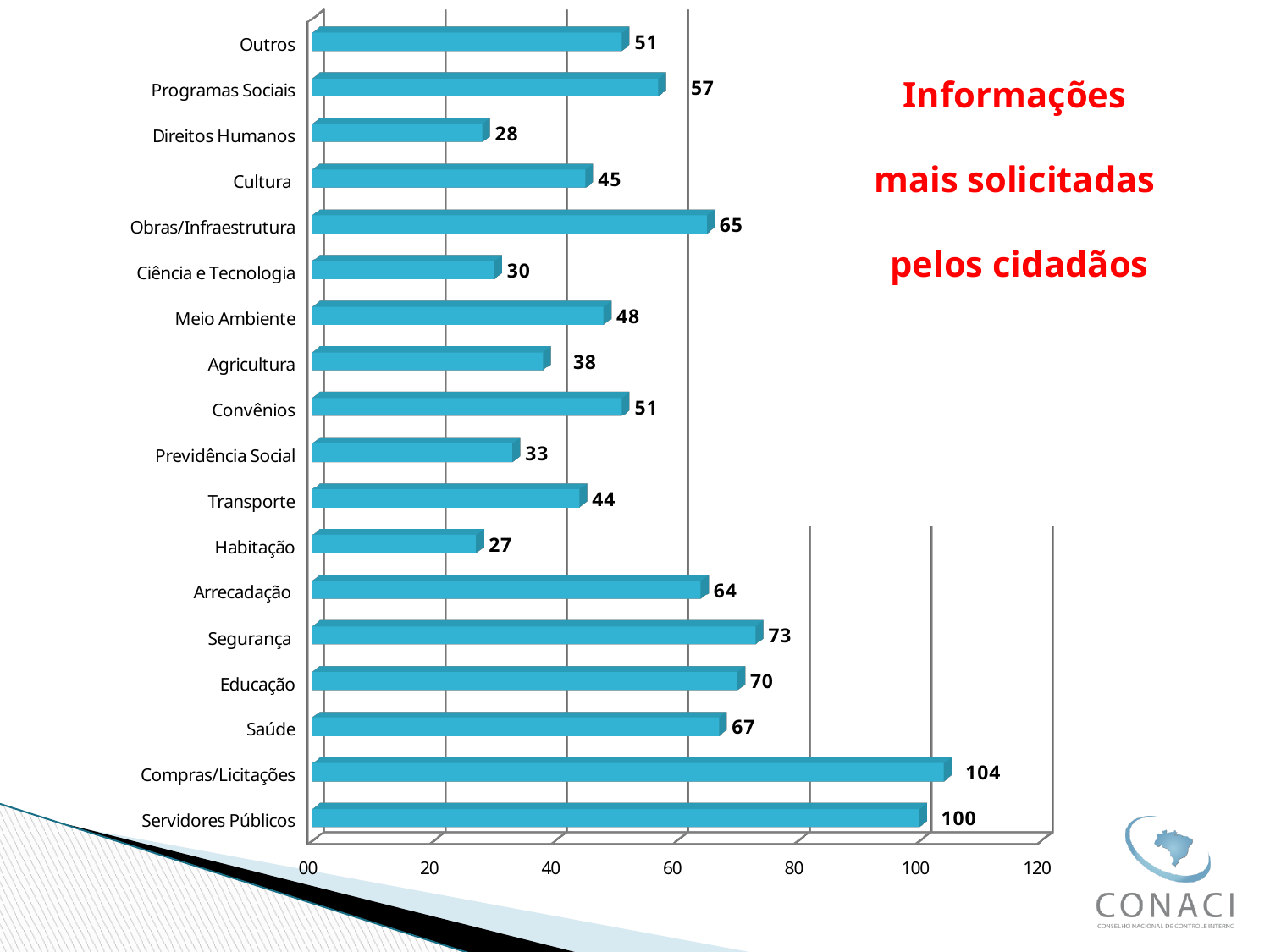
What is the value for Direitos Humanos? 28 How many categories are shown in the chart? 18 What is the difference between the values for Compras/Licitações and Servidores Públicos? 4 Which category has the highest value? Compras/Licitações Which is larger, the value for Obras/Infraestrutura or the value for Arrecadação? Obras/Infraestrutura Which category has the lowest value? Habitação What is the title text shown in red next to the chart? Informações mais solicitadas pelos cidadãos What is the value for Compras/Licitações? 104 What is the difference between the values for Segurança and Saúde? 6 What kind of chart is shown on the slide? Bar chart Is the value for Educação greater or less than 60? greater What is the value for Meio Ambiente? 48